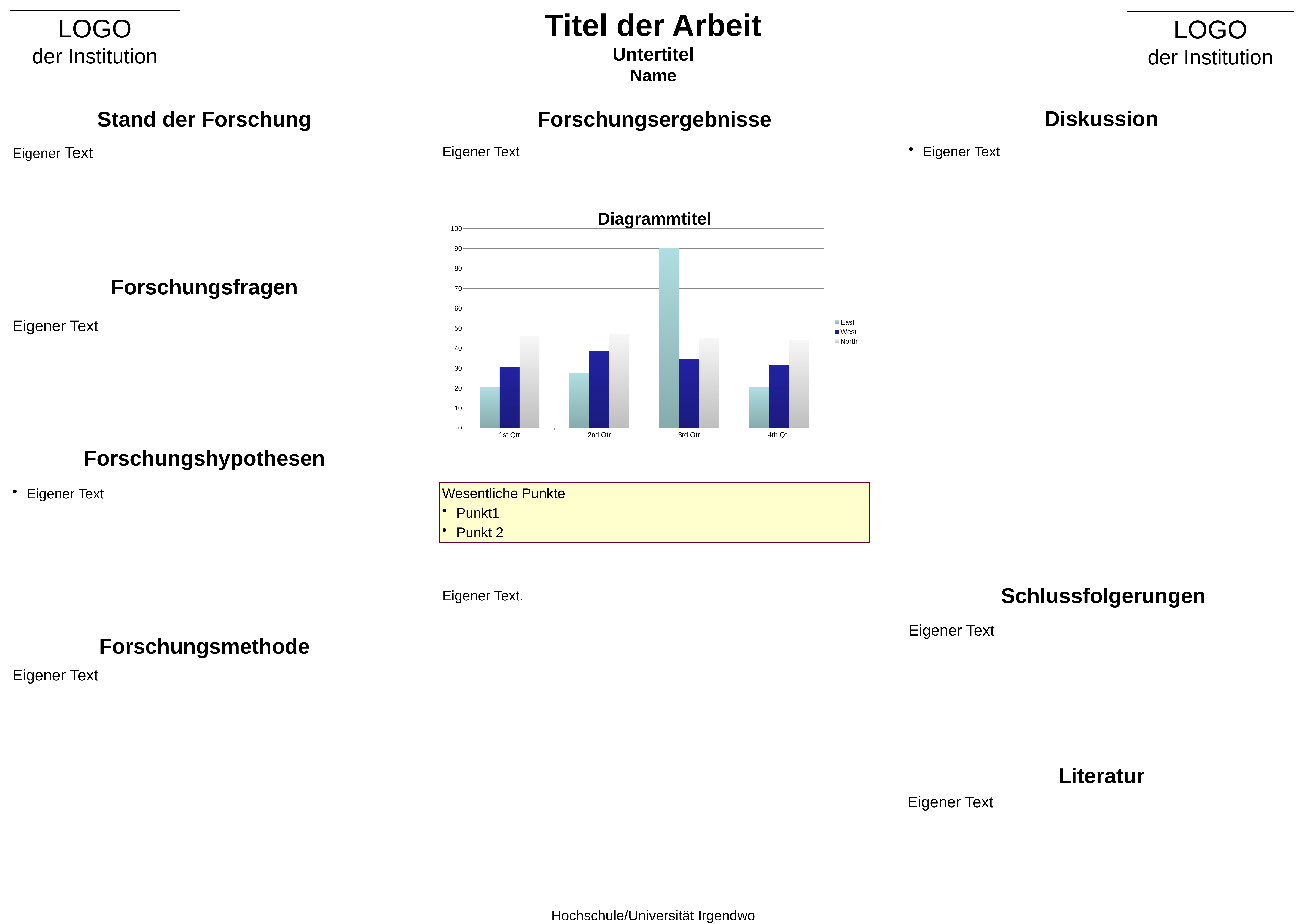
Is the value for West in 2nd Qtr greater or less than 30? greater In 1st Qtr, which is larger: East or West? West In 2nd Qtr, which is larger: West or North? North How many categories are shown on the x axis of the chart? 4 In which quarter is the West series highest? 2nd Qtr Is the value for East in 3rd Qtr greater or less than 80? greater What are the three series named in the chart legend? East, West, North How many series does the legend of the chart list? 3 Is the value for North in 1st Qtr greater or less than 40? greater What kind of chart is shown under the title "Diagrammtitel"? bar chart In which quarter is the East series highest? 3rd Qtr